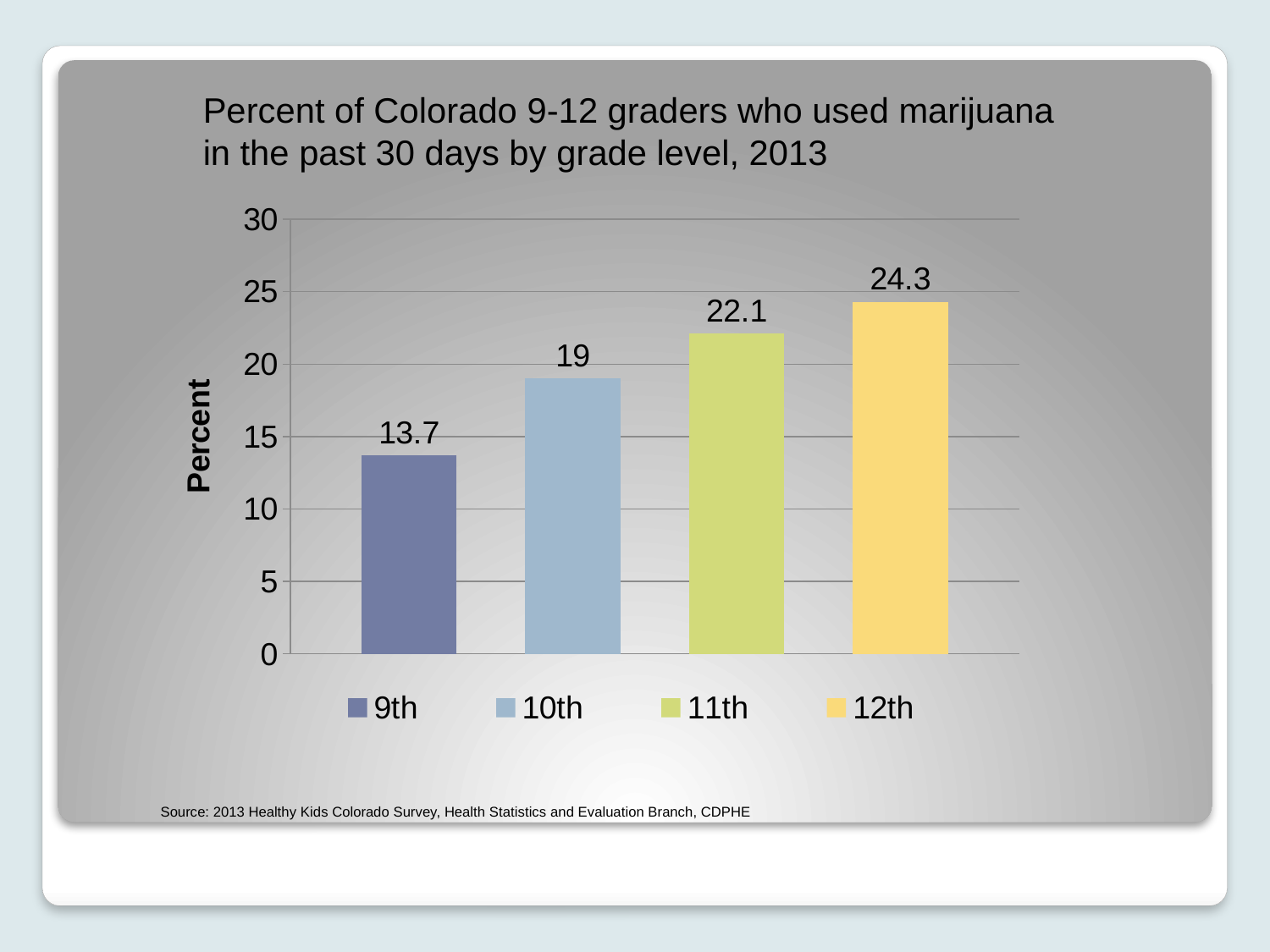
How many grade levels are shown in the chart? 4 What is the value for 11th graders? 22.1 Do the values rise or fall from 9th grade to 12th grade? Rise What is the value for 9th graders? 13.7 Is the value for 11th graders greater or less than 20? greater What is the value for 10th graders? 19 Which grade level has the lowest percent? 9th Which is larger, the value for 10th graders or the value for 11th graders? 11th Which grade level has the highest percent? 12th What kind of chart is shown on the slide? Bar chart What is the value for 12th graders? 24.3 What is the difference between the values for 12th and 9th graders? 10.6